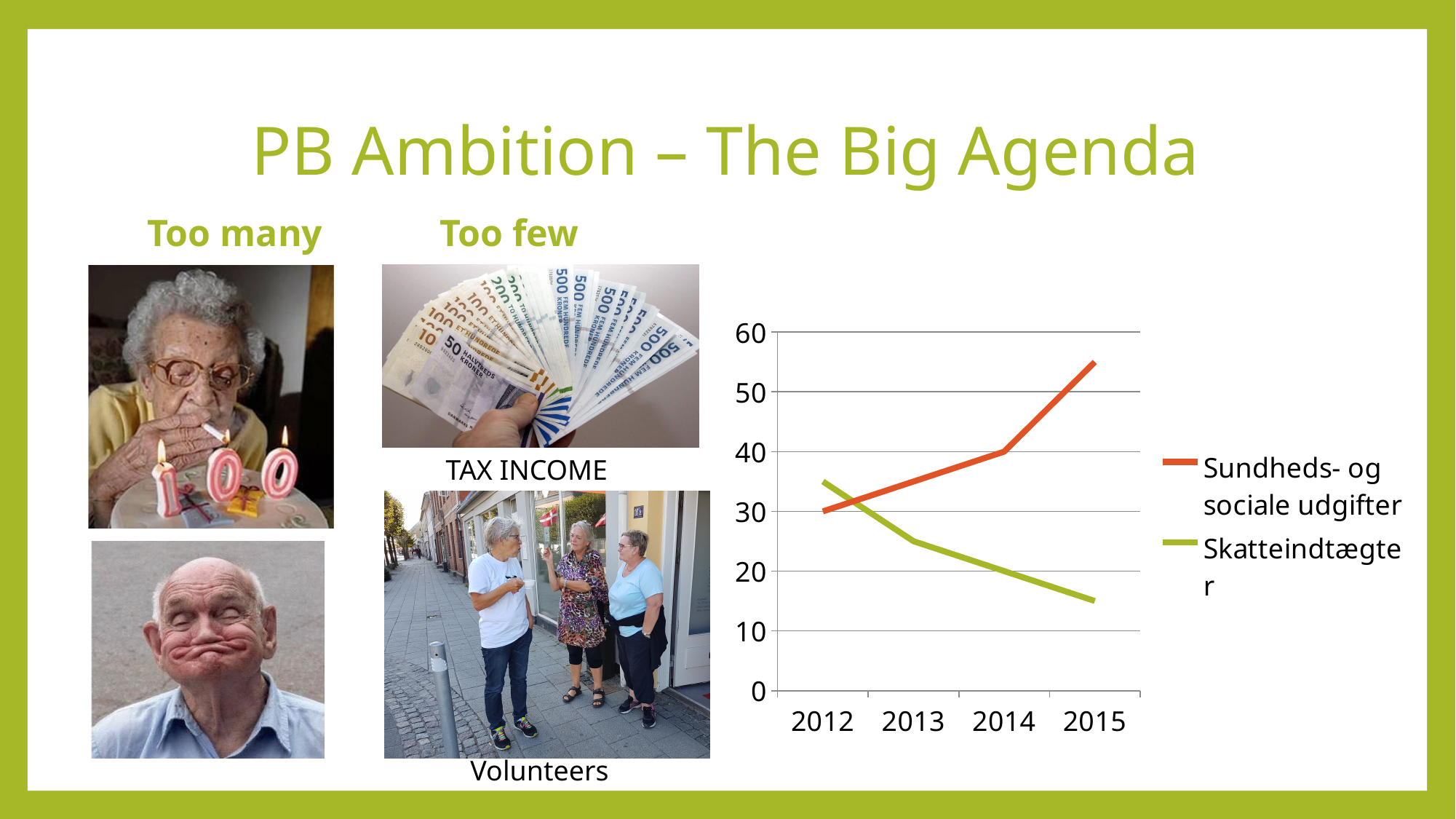
Does Sundheds- og sociale udgifter rise or fall from 2012 to 2015? rise Which colour is used for the Skatteindtægter line in the chart? green Is the value for Sundheds- og sociale udgifter in 2015 greater or less than 50? greater What is the value of Sundheds- og sociale udgifter in 2014? 40 How many years are shown on the x axis of the chart? 4 How many series does the chart legend list? 2 In 2015, which series has the higher value, Sundheds- og sociale udgifter or Skatteindtægter? Sundheds- og sociale udgifter What is the value of Skatteindtægter in 2014? 20 Is the value for Skatteindtægter in 2015 greater or less than 20? less What kind of chart is shown on the slide? line chart Does Skatteindtægter rise or fall from 2012 to 2015? fall What is the value of Sundheds- og sociale udgifter in 2012? 30